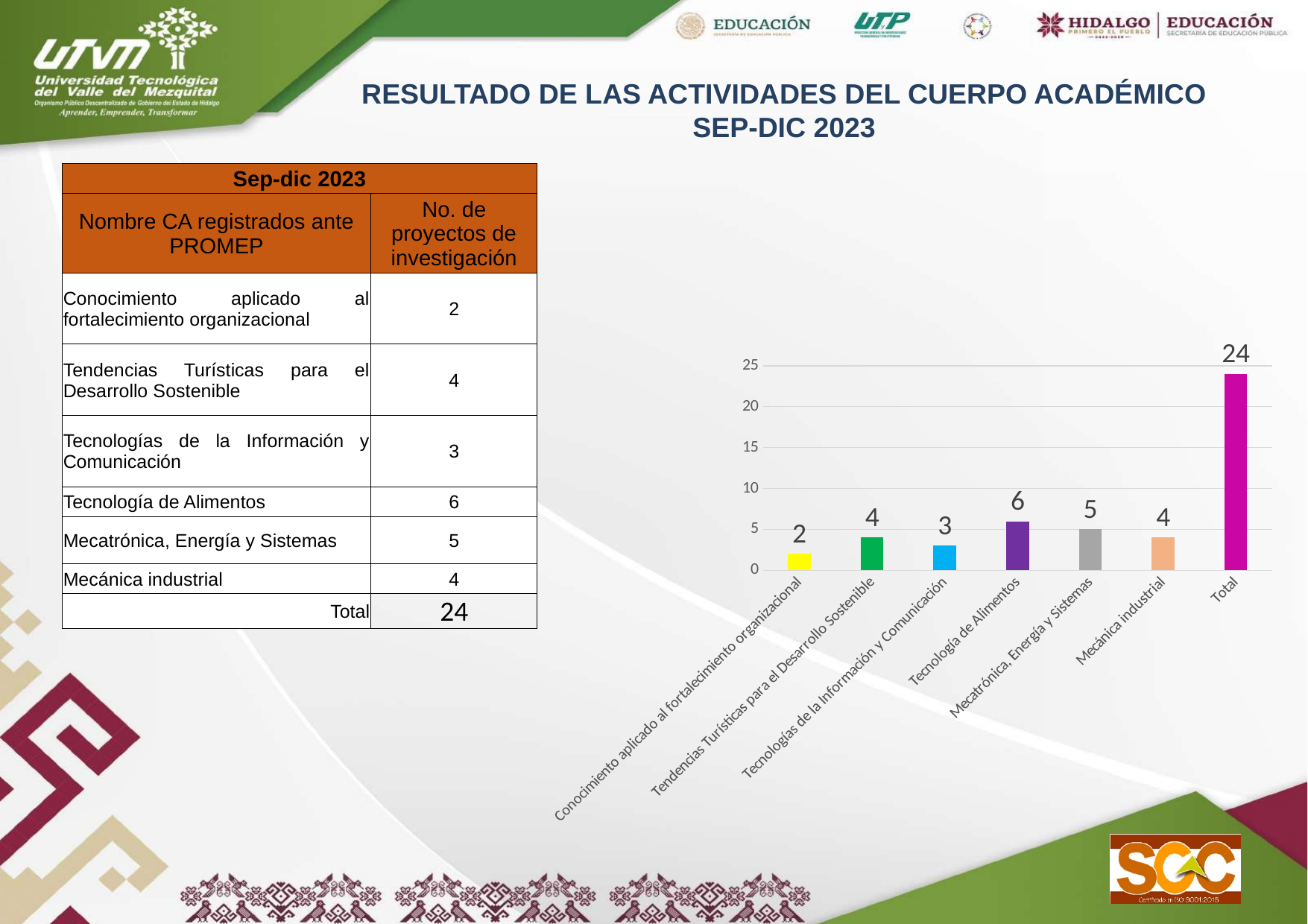
How many bars does the chart have? 7 What is the value of the bar for Mecatrónica, Energía y Sistemas? 5 Which category has the lowest value in the chart? Conocimiento aplicado al fortalecimiento organizacional What kind of chart is shown on the slide? bar chart What is the value of the bar for Conocimiento aplicado al fortalecimiento organizacional? 2 What colour is the Total bar? magenta What is the value of the bar for Tecnología de Alimentos? 6 Which is larger, the value for Mecatrónica, Energía y Sistemas or the value for Mecánica industrial? Mecatrónica, Energía y Sistemas Excluding the Total bar, which category has the highest value? Tecnología de Alimentos Is the value of the Total bar greater or less than 20? greater What is the value of the Total bar? 24 What is the difference between the values for Tecnología de Alimentos and Tecnologías de la Información y Comunicación? 3